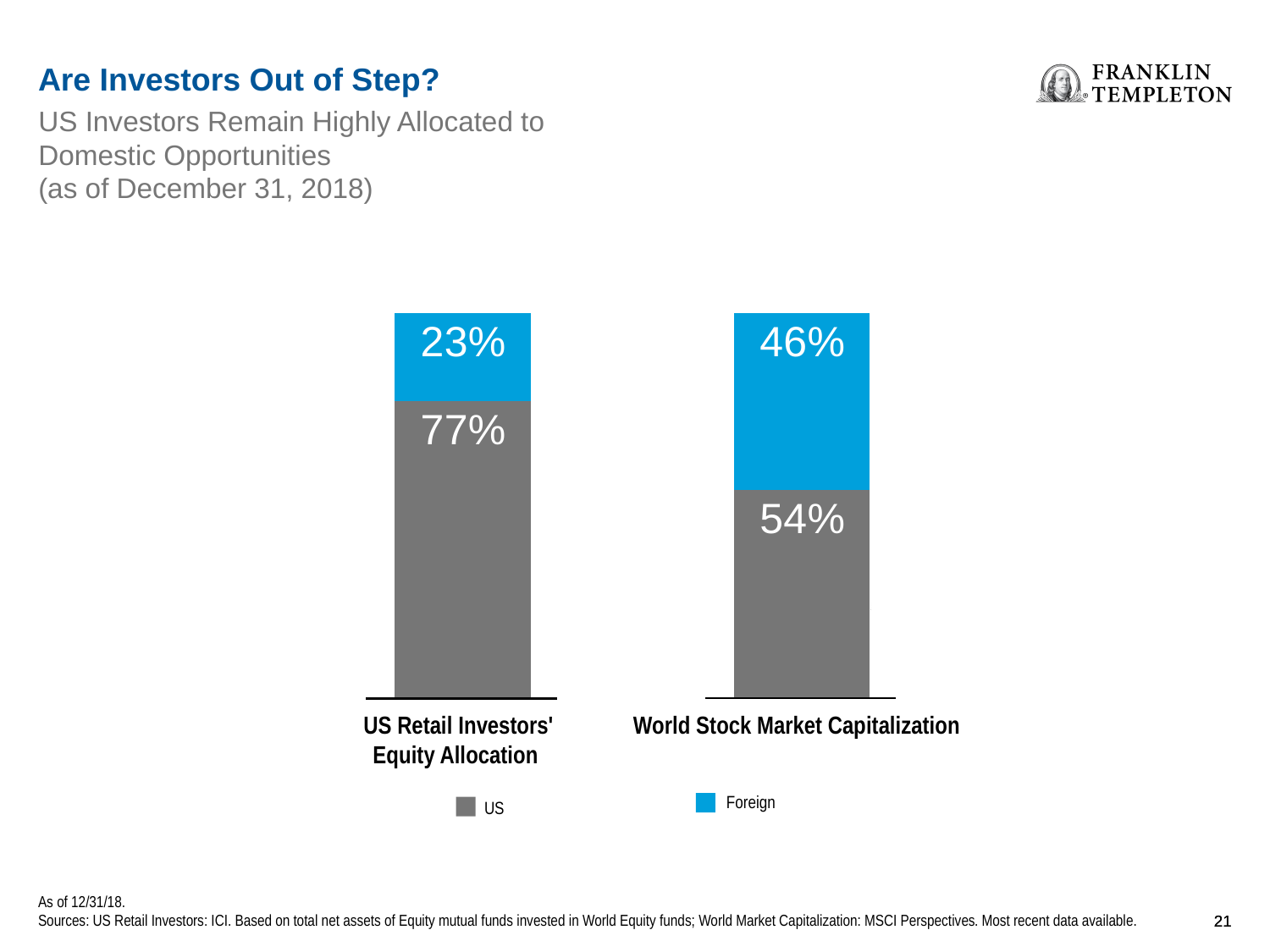
What is the Foreign share of US Retail Investors' Equity Allocation? 23% What is the difference between the US share of US Retail Investors' Equity Allocation and the US share of World Stock Market Capitalization? 23% What is the US share of US Retail Investors' Equity Allocation? 77% How many series does the legend list? 2 What kind of chart is shown on the slide? Stacked bar chart Which category has the higher Foreign share, US Retail Investors' Equity Allocation or World Stock Market Capitalization? World Stock Market Capitalization What is the Foreign share of World Stock Market Capitalization? 46% How many categories are shown on the x axis? 2 What is the total of the stacked bar for US Retail Investors' Equity Allocation? 100% What is the difference between the Foreign share of World Stock Market Capitalization and the Foreign share of US Retail Investors' Equity Allocation? 23% Which category has the higher US share? US Retail Investors' Equity Allocation What is the US share of World Stock Market Capitalization? 54%